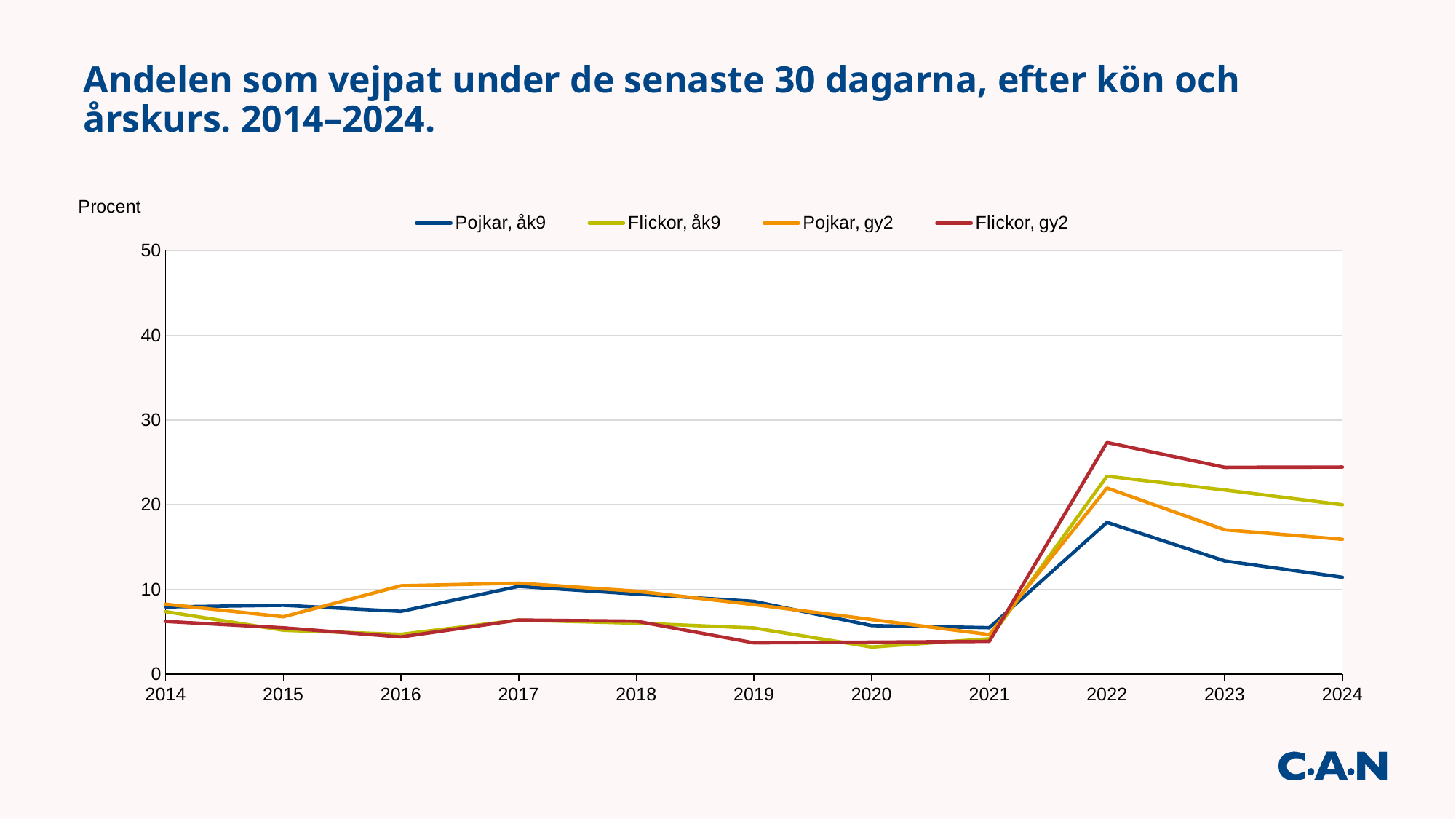
Does the value for Pojkar, åk9 rise or fall from 2022 to 2024? fall Is the value for Pojkar, gy2 in 2023 greater or less than 20? less Which series has the lowest value in 2024? Pojkar, åk9 In 2022, which is larger: the value for Flickor, gy2 or the value for Pojkar, åk9? Flickor, gy2 Is the value for Pojkar, åk9 in 2024 greater or less than 10? greater Is the value for Flickor, gy2 in 2022 greater or less than 20? greater How many series does the legend list? 4 Which series has the highest value in 2024? Flickor, gy2 How many years are shown along the x axis? 11 What label is shown on the y axis? Procent What kind of chart is shown on the slide? line chart